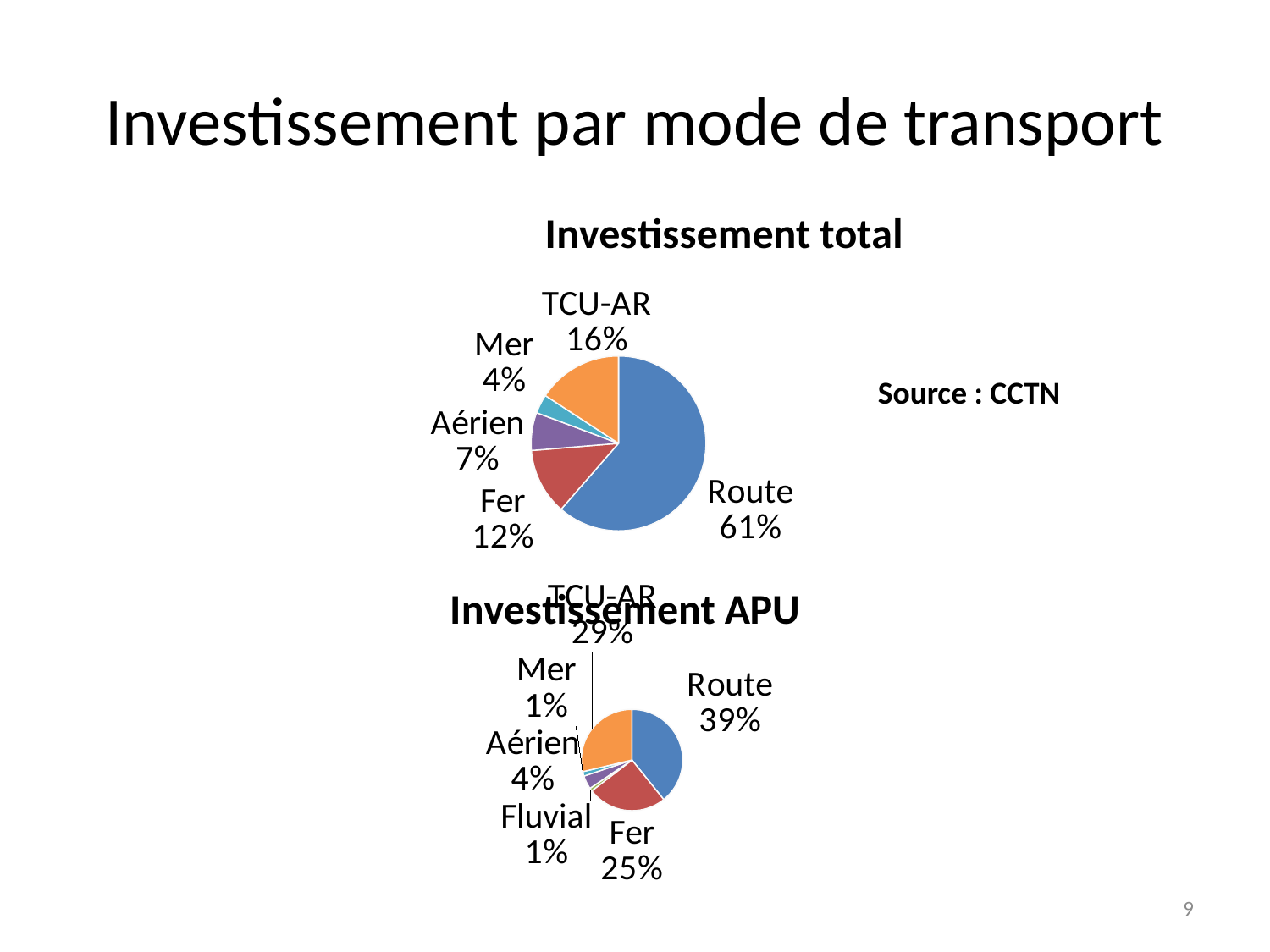
How many slices does the 'Investissement total' chart have? 5 In the 'Investissement APU' chart, which is larger, TCU-AR or Fer? TCU-AR In the 'Investissement APU' chart, what is the difference between the shares of Route and TCU-AR? 10% What type of chart is the 'Investissement total' chart? Pie chart How many slices does the 'Investissement APU' chart have? 6 In the 'Investissement total' chart, what is the difference between the shares of Fer and Aérien? 5% In the 'Investissement APU' chart, what share does Route have? 39% In the 'Investissement total' chart, which mode has the smallest share? Mer In the 'Investissement total' chart, what share does Route have? 61% In the 'Investissement APU' chart, what is the value for Fer? 25% In the 'Investissement total' chart, what is the value for TCU-AR? 16% In the 'Investissement APU' chart, which mode has the largest share? Route